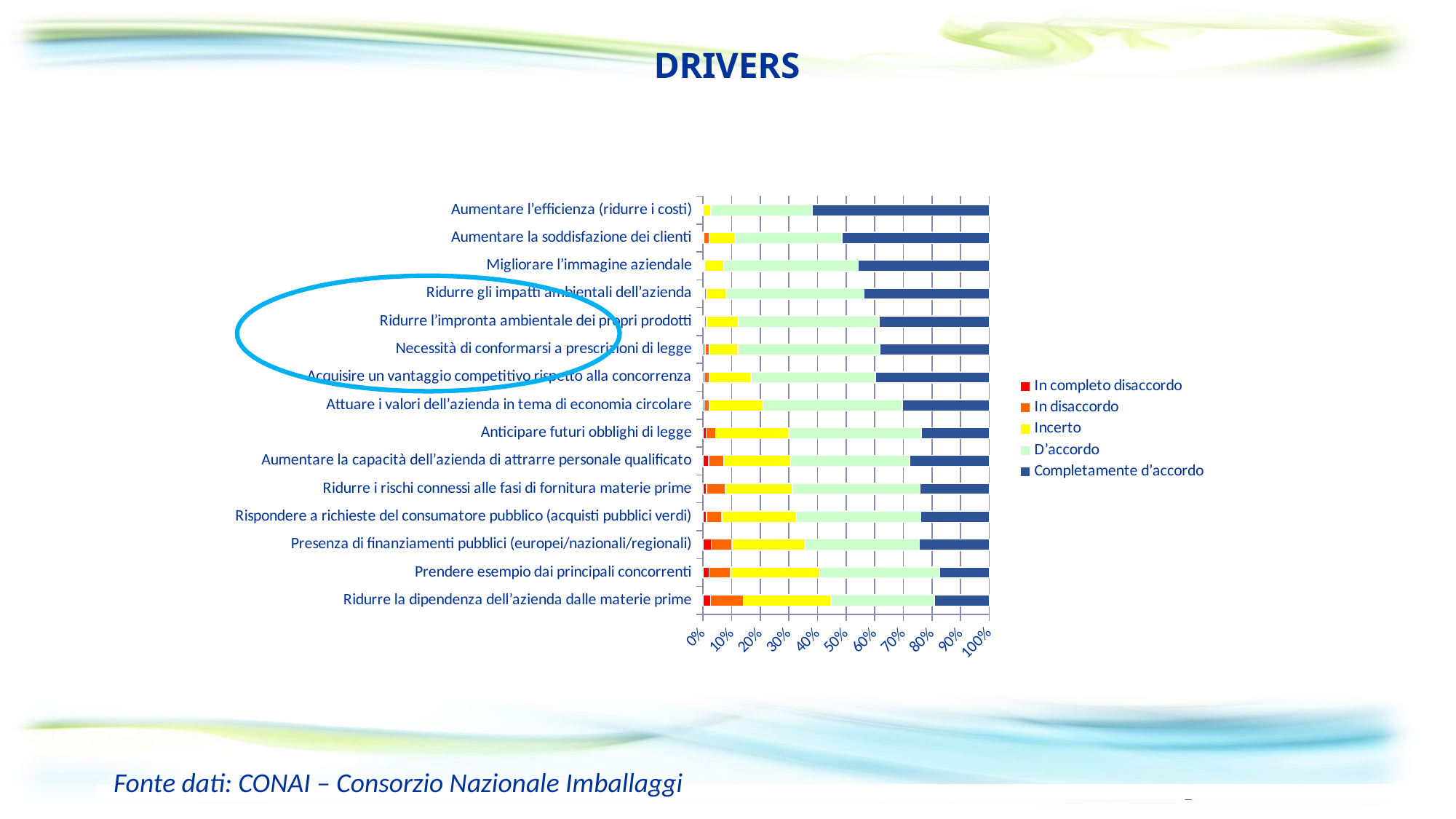
What does each stacked bar total on the percentage axis? 100% Which category has the largest 'Completamente d'accordo' segment? Aumentare l'efficienza (ridurre i costi) Is the 'Completamente d'accordo' share for 'Aumentare l'efficienza (ridurre i costi)' greater or less than 50%? greater Is the 'Incerto' share for 'Aumentare l'efficienza (ridurre i costi)' greater or less than 10%? less Which has a larger 'Completamente d'accordo' share: 'Aumentare la soddisfazione dei clienti' or 'Presenza di finanziamenti pubblici (europei/nazionali/regionali)'? Aumentare la soddisfazione dei clienti Is the 'Incerto' share for 'Prendere esempio dai principali concorrenti' greater or less than 20%? greater What kind of chart is shown on the slide? Stacked bar chart What is the title of the slide containing the chart? DRIVERS How many series does the legend list? 5 Which legend entry is shown in yellow? Incerto How many categories (drivers) are listed on the chart? 15